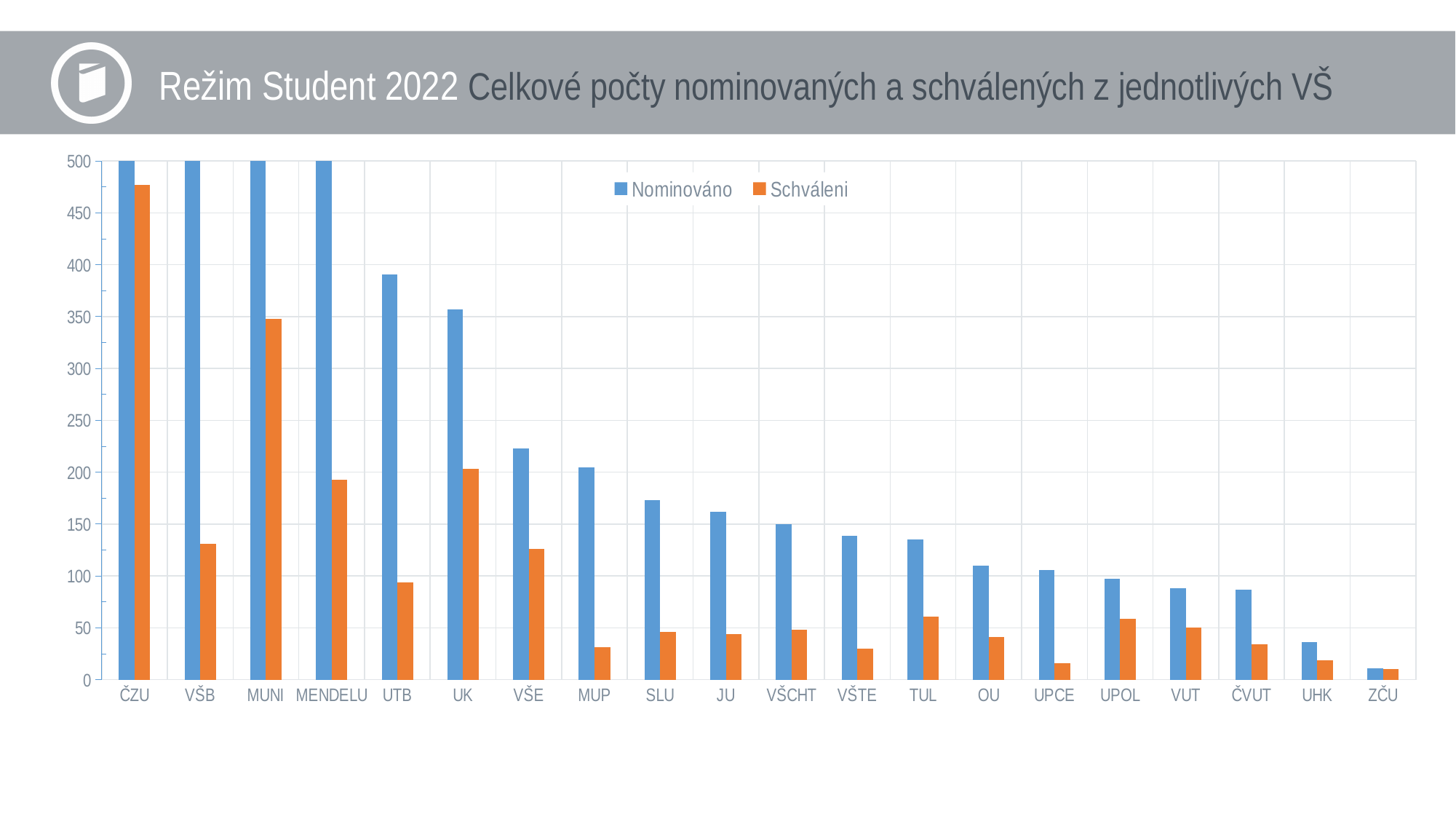
Which university has the highest Schváleni value? ČZU Which university has the lowest Nominováno value? ZČU How many series does the legend list? 2 Is the Nominováno value for SLU greater or less than 200? less Is the Nominováno value for UHK greater or less than 50? less Which is larger: the Schváleni value for ČZU or the Schváleni value for VŠB? ČZU What kind of chart is shown on the slide? bar chart Is the Schváleni value for ČZU greater or less than 450? greater How many universities (categories) are shown on the x axis? 20 Do the Nominováno values generally rise or fall from left to right along the x axis? fall